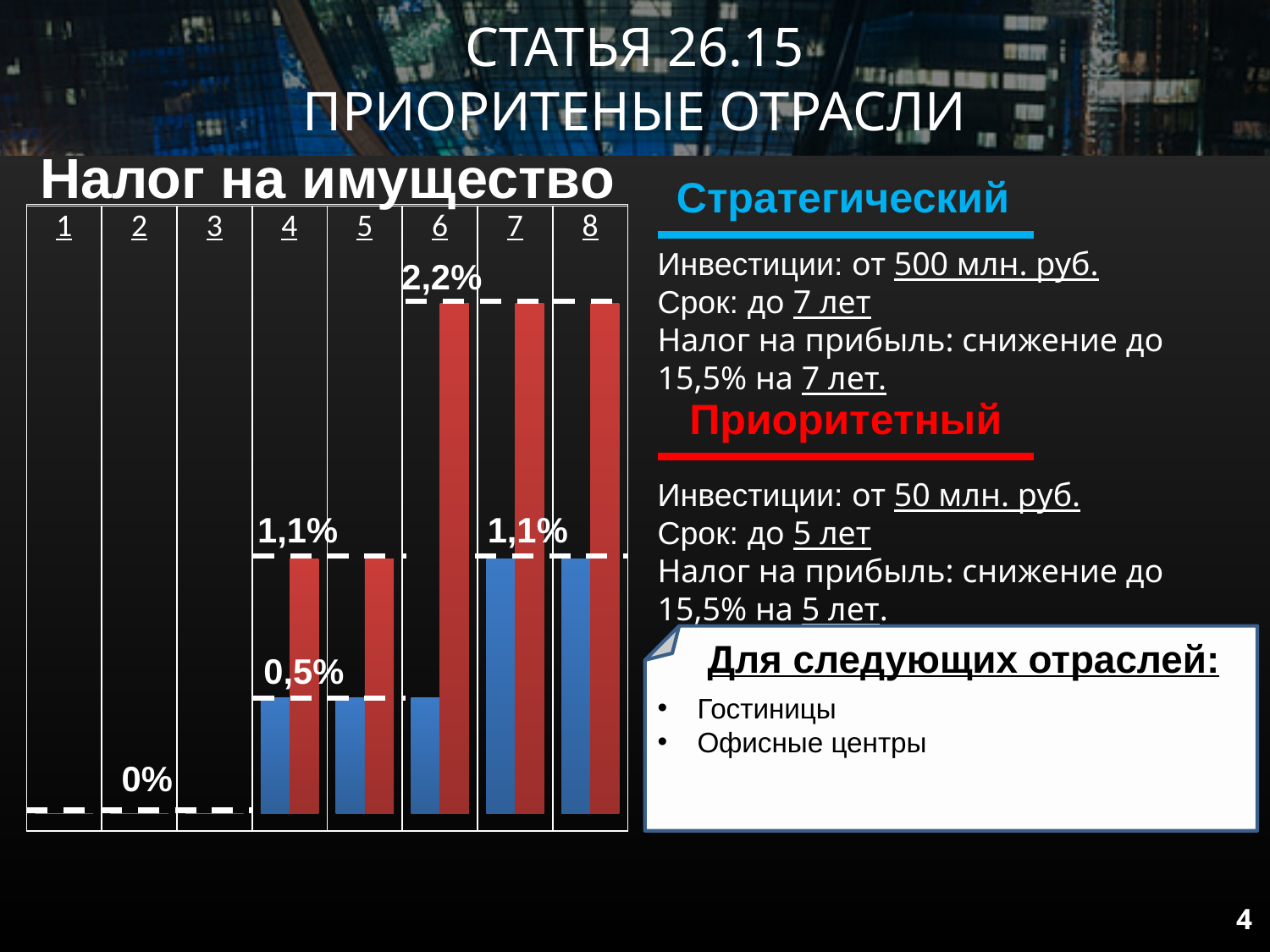
What kind of chart is shown under the heading "Налог на имущество"? bar chart What is the title of the chart on the slide? Налог на имущество What is the value of the blue bar for year 7 in the "Налог на имущество" chart? 1,1% What is the difference between the red bar and the blue bar in year 6 of the "Налог на имущество" chart? 1,7% What is the value of the blue bar for year 4 in the "Налог на имущество" chart? 0,5% How many categories (years) are shown on the x axis of the "Налог на имущество" chart? 8 In which year does the red bar in the "Налог на имущество" chart first reach 2,2%? 6 Do the values in the "Налог на имущество" chart rise or fall from year 1 to year 8? rise In year 6 of the "Налог на имущество" chart, which bar is taller, the red or the blue? red What value is shown for year 2 in the "Налог на имущество" chart? 0% What is the value of the red bar for year 4 in the "Налог на имущество" chart? 1,1% What is the value of the red bar for year 6 in the "Налог на имущество" chart? 2,2%